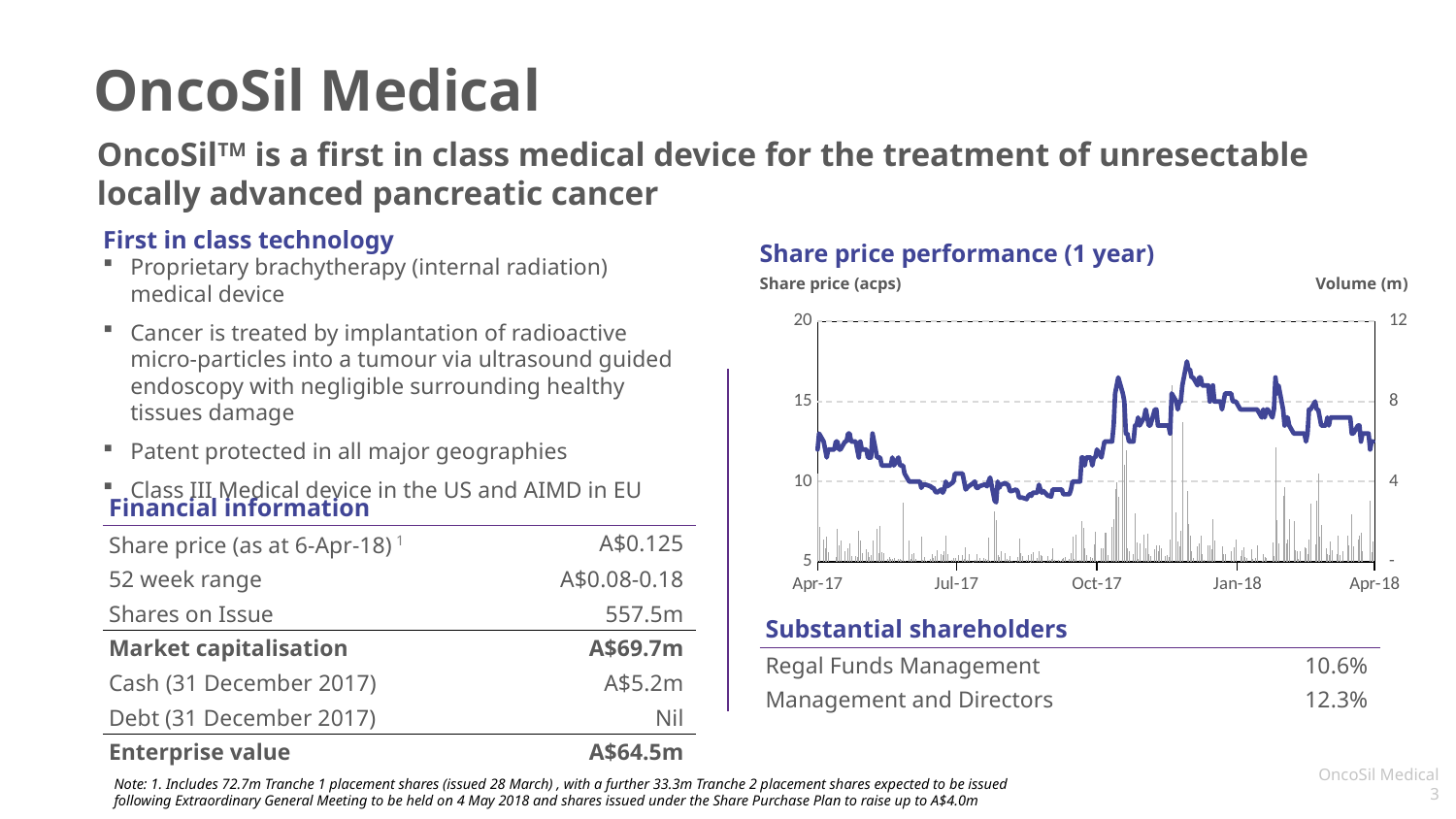
Does the share price rise or fall between Jul-17 and Oct-17? rise Is the share price at Apr-18 greater or less than 10? greater What is the title of the chart on the slide? Share price performance (1 year) Does the share price rise or fall between Apr-17 and Jul-17? fall Is the highest share price reached during the year greater or less than 15? greater Between which two x-axis labels does the share price reach its highest point? Oct-17 and Jan-18 What is the label of the right-hand axis of the share price chart? Volume (m) Is the share price at Apr-18 greater or less than 15? less What kind of chart is the Share price performance (1 year) chart? combination bar and line chart How many date labels are shown on the x axis of the share price chart? 5